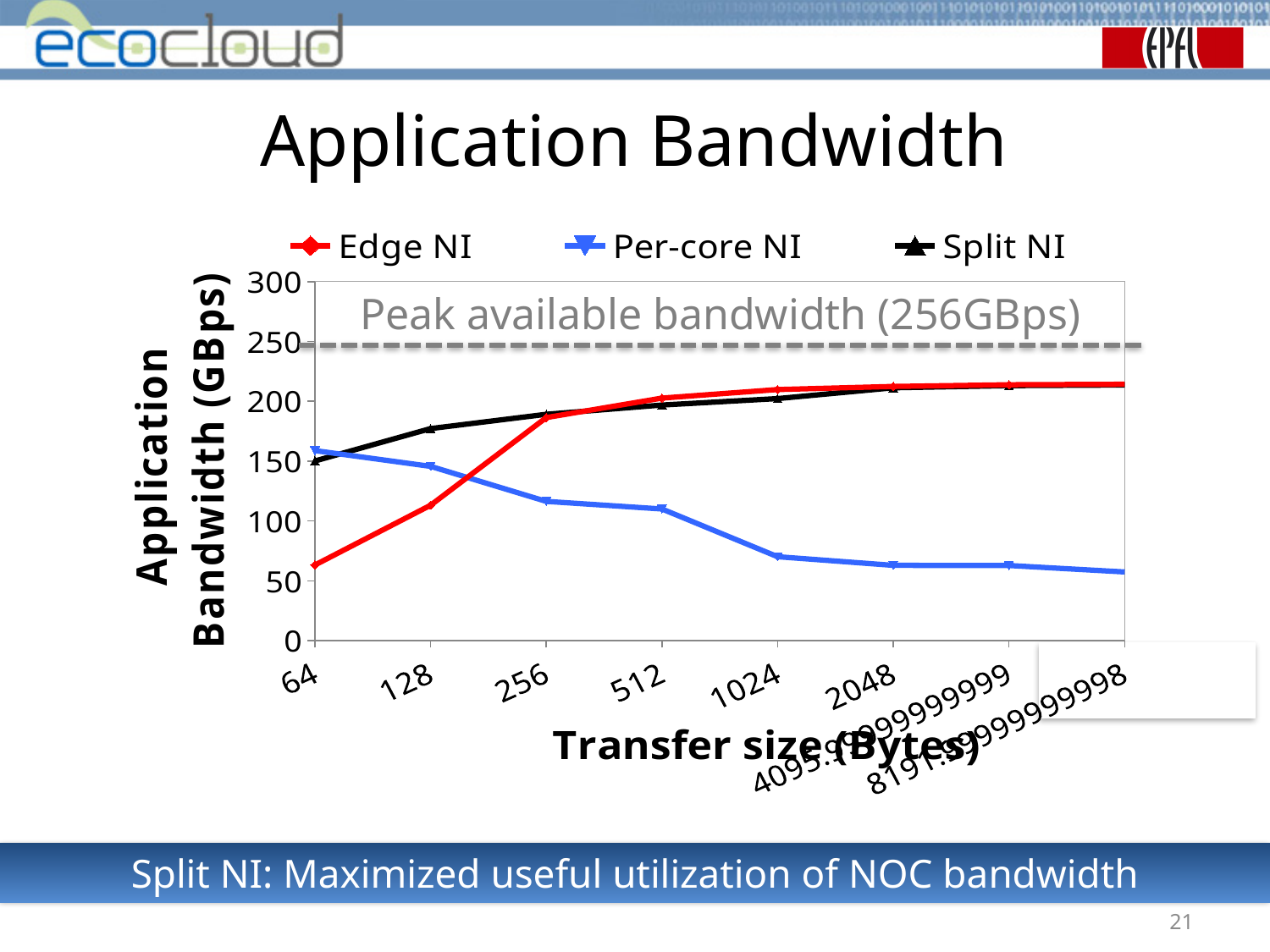
At a transfer size of 64 bytes, which is larger: Edge NI or Per-core NI? Per-core NI Is the value for Per-core NI at a transfer size of 1024 bytes greater or less than 100? less How many series does the legend list? 3 Which series has the lowest bandwidth at the largest transfer size? Per-core NI Does the Per-core NI bandwidth rise or fall as transfer size increases? fall What kind of chart is shown on the slide? line chart At a transfer size of 128 bytes, which is larger: Split NI or Edge NI? Split NI How many transfer sizes are marked along the x axis? 8 Is the value for Split NI at a transfer size of 2048 bytes greater or less than 200? greater What peak available bandwidth is indicated by the dashed line? 256GBps Is the value for Edge NI at a transfer size of 64 bytes greater or less than 100? less Does the Edge NI bandwidth rise or fall as transfer size increases? rise